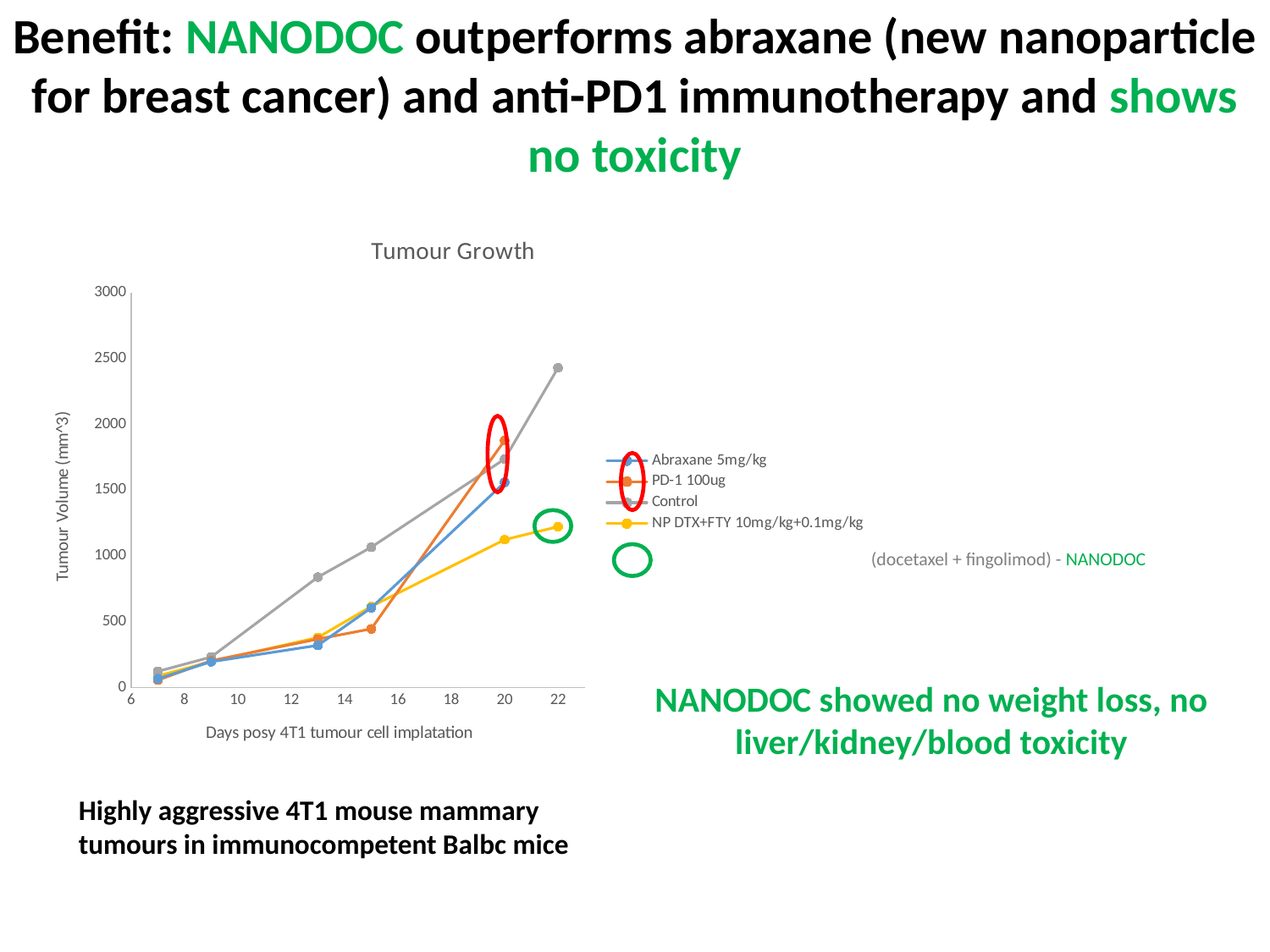
Which series has the lowest tumour volume at day 20? NP DTX+FTY 10mg/kg+0.1mg/kg Does the Control tumour volume rise or fall as the days increase? Rise Which series has the highest tumour volume at day 22? Control Which series has the lowest tumour volume at day 22? NP DTX+FTY 10mg/kg+0.1mg/kg Is the NP DTX+FTY 10mg/kg+0.1mg/kg tumour volume at day 22 greater or less than 1500? less At day 22, which is larger: the tumour volume for Control or for NP DTX+FTY 10mg/kg+0.1mg/kg? Control Is the Control tumour volume at day 22 greater or less than 2000? greater What type of chart is shown on the slide? Line chart What is the label of the y axis of the chart? Tumour Volume (mm^3) How many series does the chart legend list? 4 What is the title of the chart? Tumour Growth Is the PD-1 100ug tumour volume at day 20 greater or less than 1500? greater